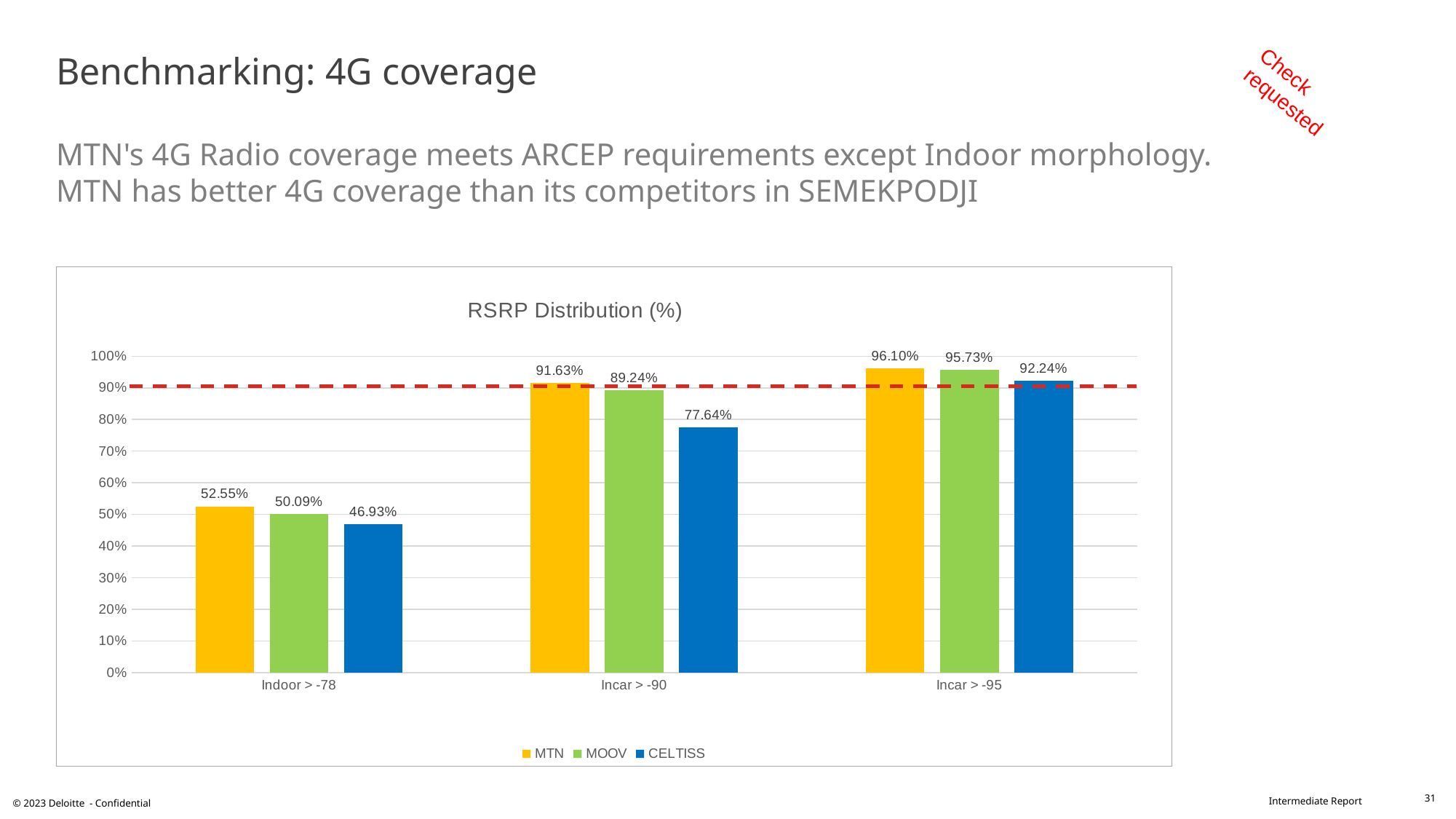
How many series does the legend list? 3 What kind of chart is shown on the slide? Bar chart What is the title of the chart? RSRP Distribution (%) Which operator has the lowest value in the Indoor > -78 category? CELTISS Is the value for MOOV in the Incar > -90 category greater or less than 90%? less What is the value for MOOV in the Incar > -95 category? 95.73% Which is larger in the Incar > -90 category, MOOV or CELTISS? MOOV What is the value for MTN in the Indoor > -78 category? 52.55% Which operator has the highest value in the Incar > -95 category? MTN What is the difference between MTN and CELTISS in the Incar > -90 category? 13.99% How many categories are shown on the x axis? 3 What is the value for CELTISS in the Incar > -90 category? 77.64%